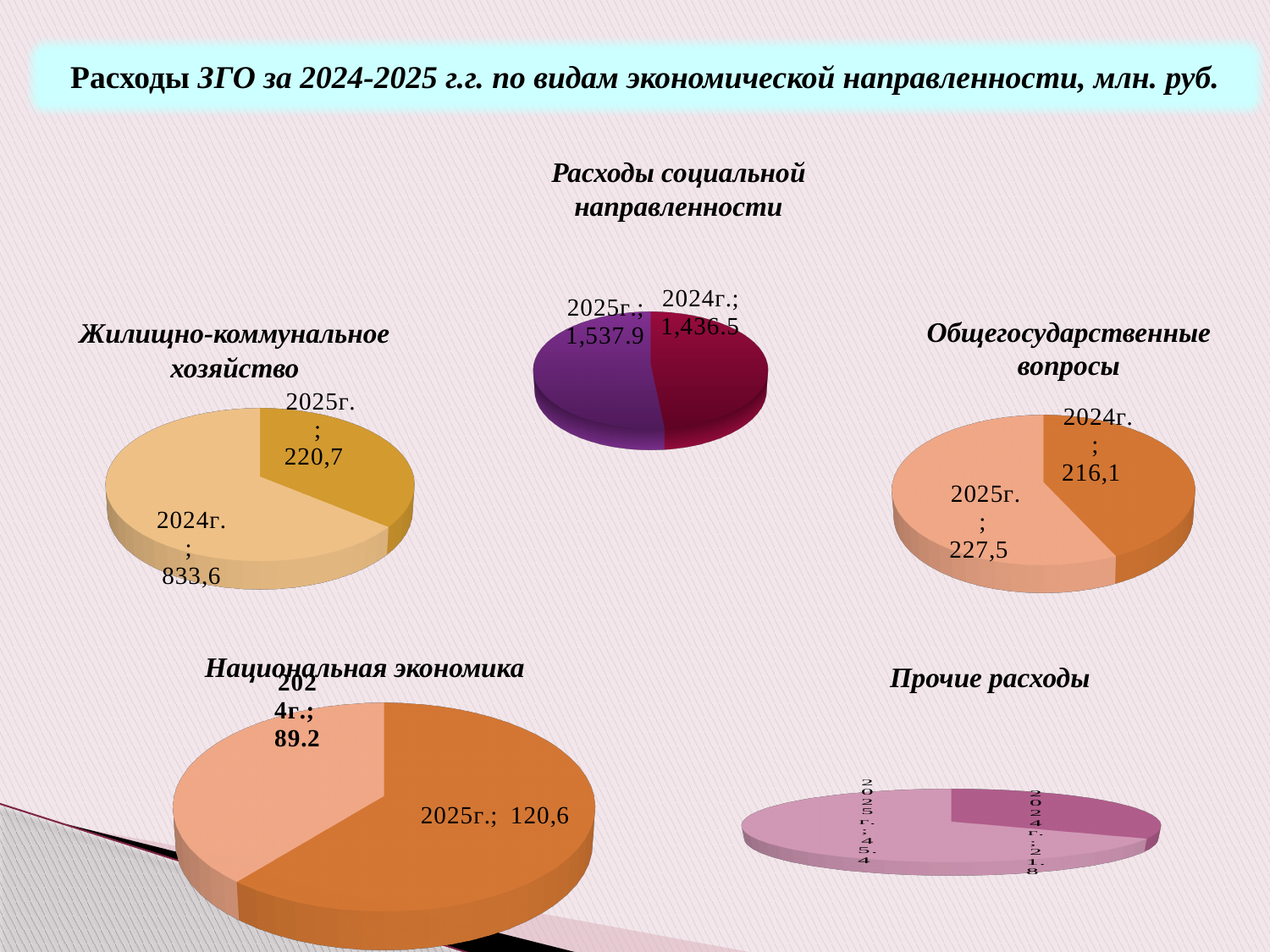
On the 'Расходы социальной направленности' chart, what is the value for 2024г.? 1,436.5 On the 'Национальная экономика' chart, what is the value for 2025г.? 120,6 On the 'Прочие расходы' chart, which slice is larger, 2024г. or 2025г.? 2025г. What type of chart is used for 'Общегосударственные вопросы'? Pie chart On the 'Жилищно-коммунальное хозяйство' chart, what is the difference between the 2024г. and 2025г. values? 612,9 On the 'Национальная экономика' chart, what is the value for 2024г.? 89.2 On the 'Жилищно-коммунальное хозяйство' chart, what is the value for 2025г.? 220,7 On the 'Жилищно-коммунальное хозяйство' chart, which year has the larger value, 2024г. or 2025г.? 2024г. On the 'Жилищно-коммунальное хозяйство' chart, what is the value for 2024г.? 833,6 On the 'Общегосударственные вопросы' chart, what is the value for 2025г.? 227,5 On the 'Национальная экономика' chart, what is the difference between the 2025г. and 2024г. values? 31.4 On the 'Расходы социальной направленности' chart, what is the value for 2025г.? 1,537.9